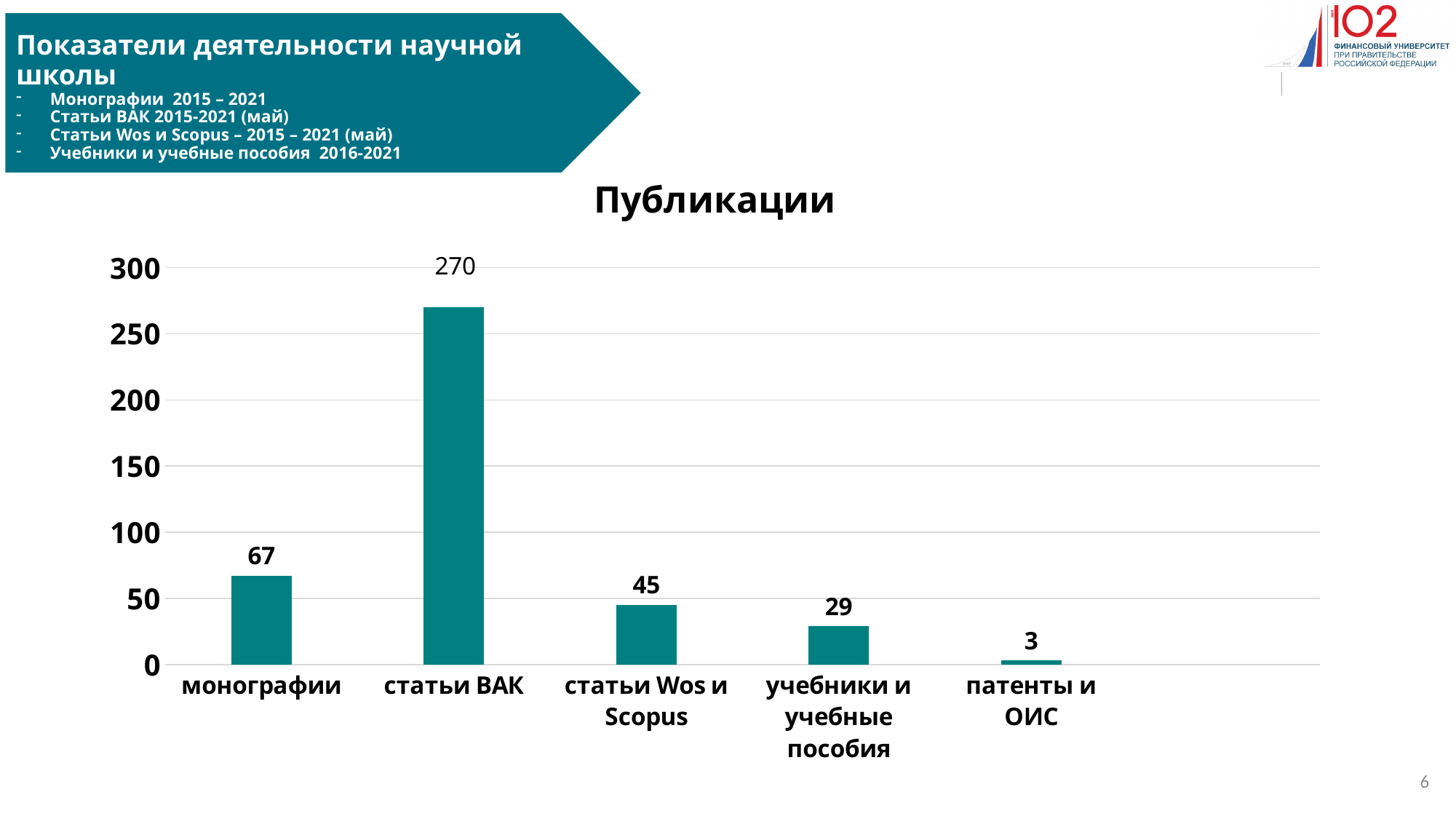
What is the title of the chart? Публикации Which category has the highest value? статьи ВАК What is the difference between the values for статьи Wos и Scopus and учебники и учебные пособия? 16 What is the value for патенты и ОИС? 3 What is the value for монографии? 67 Which is larger, the value for монографии or the value for статьи Wos и Scopus? монографии What is the value for статьи ВАК? 270 What kind of chart is shown on the slide? bar chart How many categories are shown on the x axis? 5 What is the value for учебники и учебные пособия? 29 What is the difference between the values for статьи ВАК and монографии? 203 Which category has the lowest value? патенты и ОИС